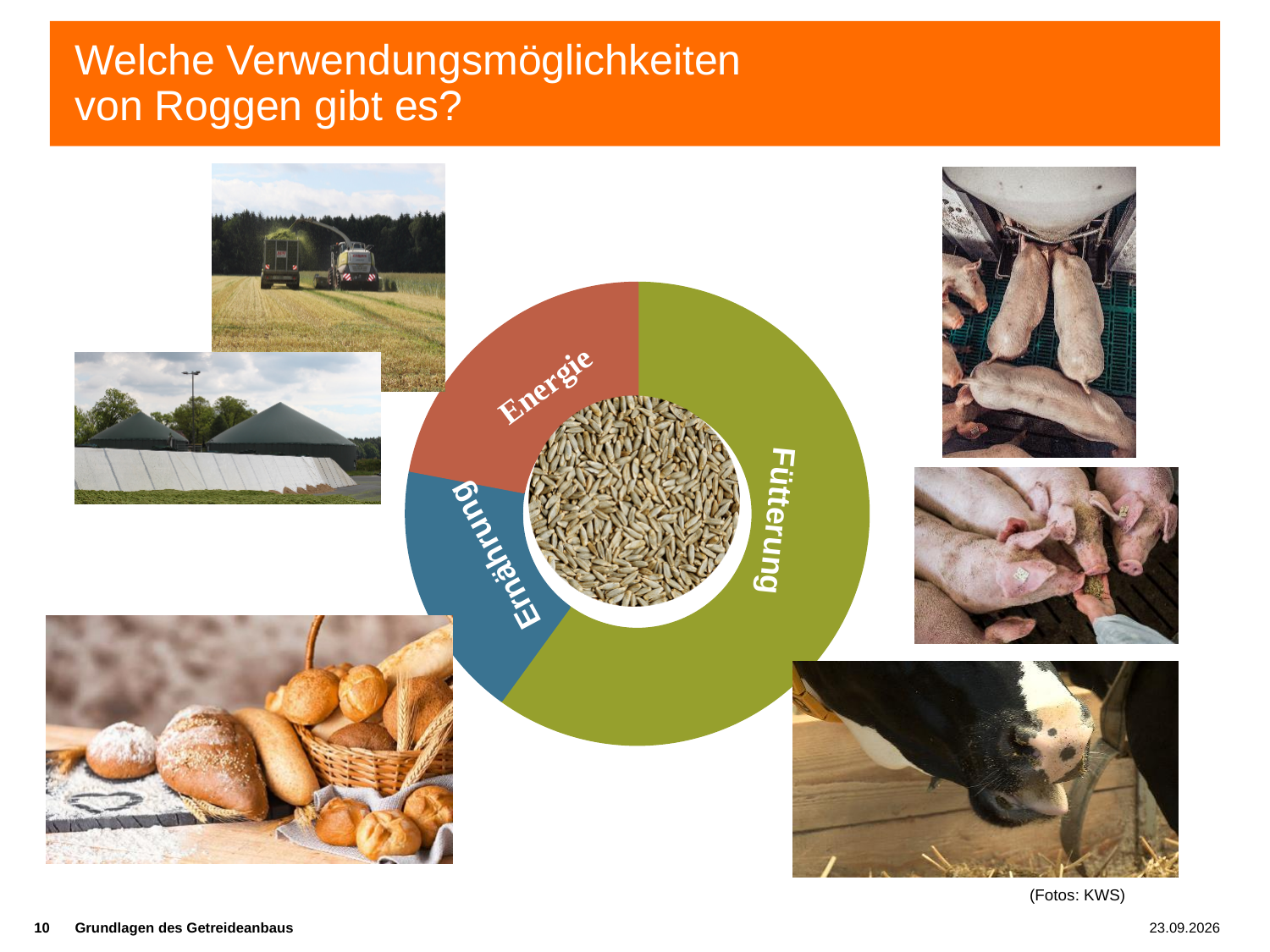
How many segments does the donut chart have? 3 What are the three uses of rye labelled in the donut chart? Energie, Ernährung, Fütterung What kind of chart is shown in the centre of the slide? Pie chart (donut) What colour is the Fütterung segment of the donut chart? Green Which is larger in the donut chart, Fütterung or Energie? Fütterung Which is larger in the donut chart, Fütterung or Ernährung? Fütterung Which segment of the donut chart is the largest? Fütterung